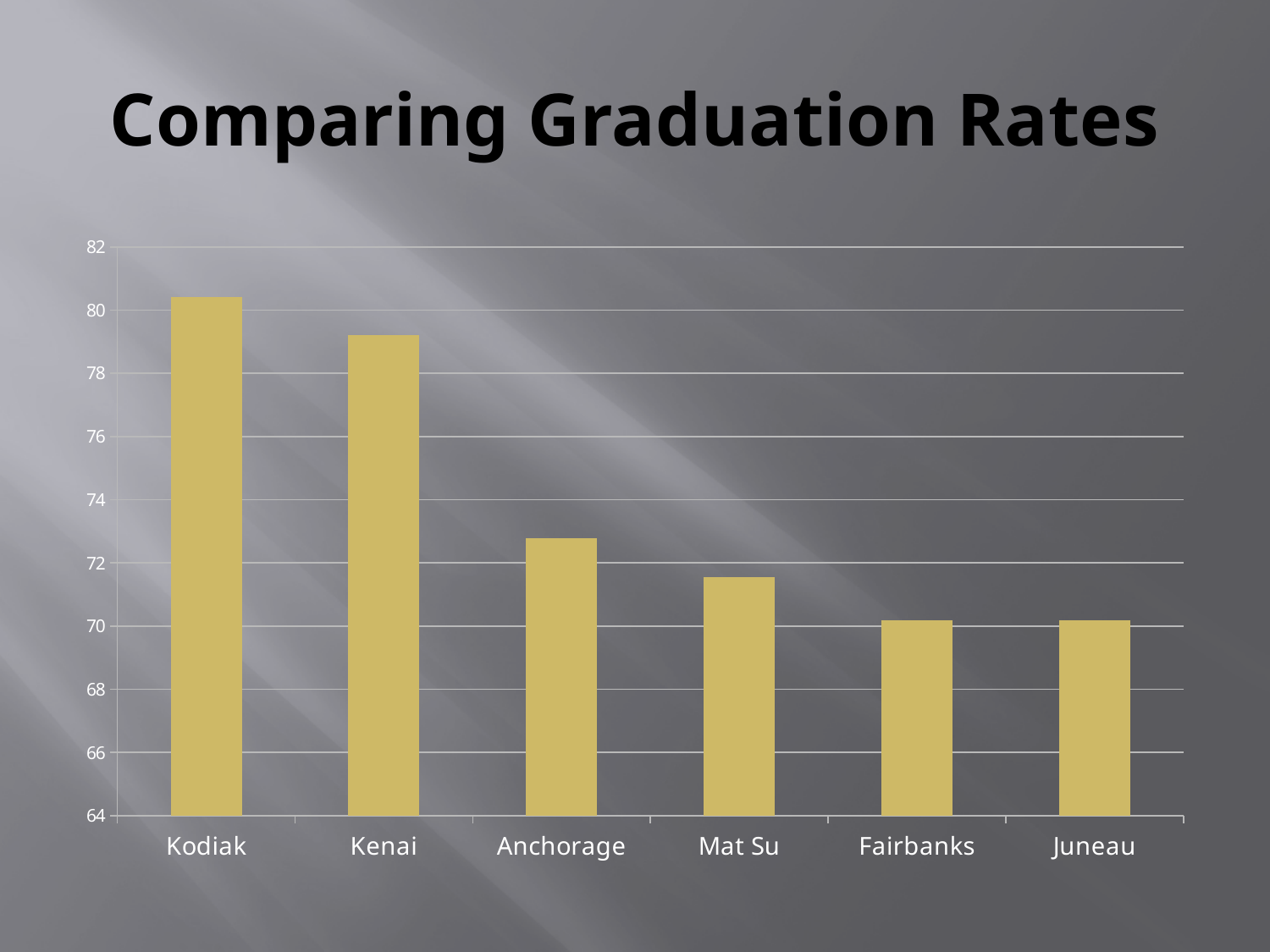
Which category has the highest value in the chart? Kodiak Which is larger, the value for Anchorage or the value for Mat Su? Anchorage What is the title of the chart? Comparing Graduation Rates Which is larger, the value for Kenai or the value for Anchorage? Kenai Is the value for Kenai greater or less than 80? less What kind of chart is shown on the slide? bar chart Is the value for Mat Su greater or less than 72? less Is the value for Anchorage greater or less than 72? greater Do the values generally rise or fall moving from left to right along the x axis? fall How many categories are shown on the x axis of the chart? 6